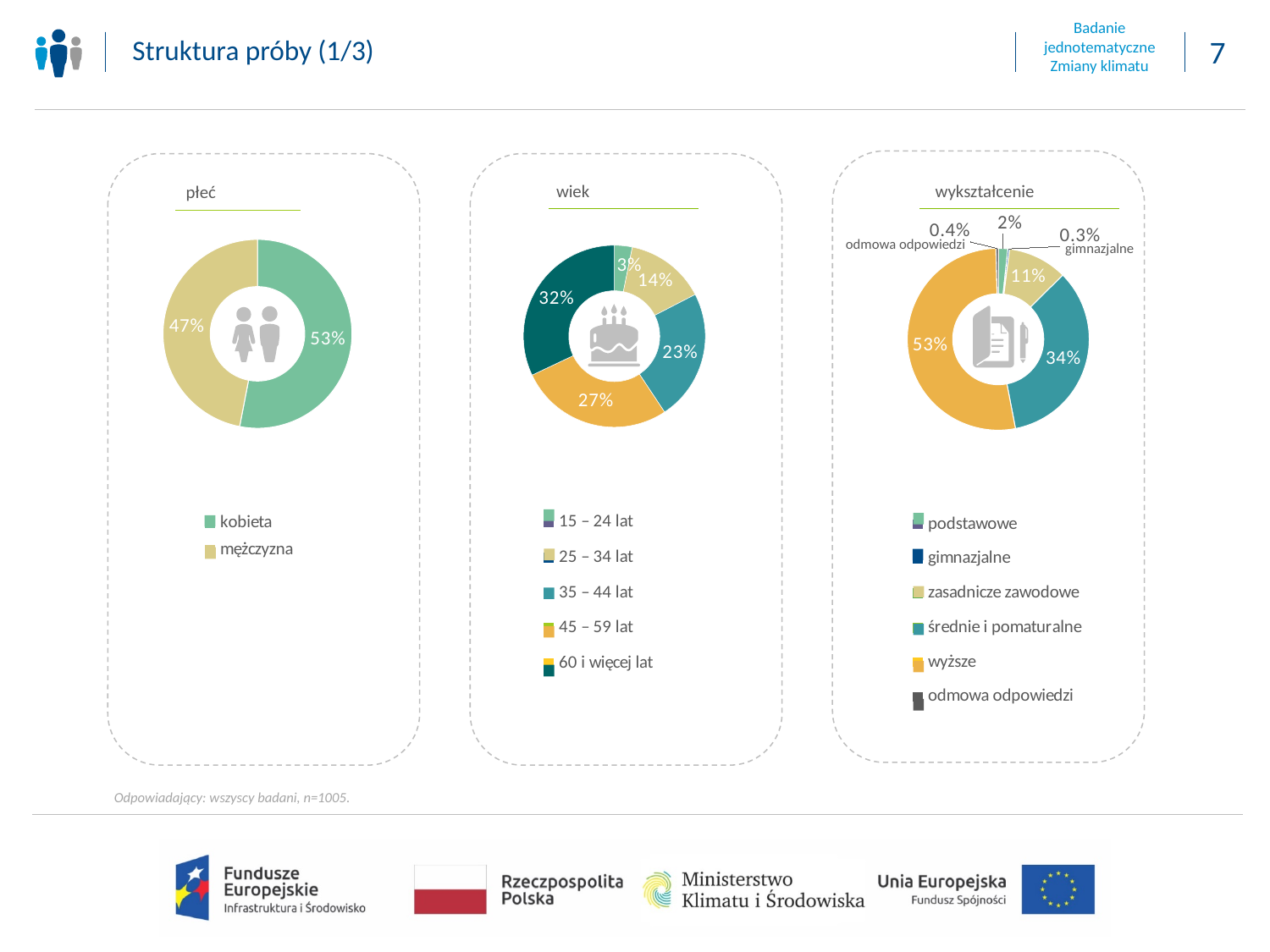
In the 'wykształcenie' chart, what percentage is shown for wyższe? 53% In the 'wykształcenie' chart, what percentage is shown for gimnazjalne? 0.3% In the 'wiek' chart, which age group has the smallest share? 15 – 24 lat In the 'płeć' chart, what percentage is shown for mężczyzna? 47% In the 'płeć' chart, what percentage is shown for kobieta? 53% In the 'wiek' chart, what percentage is shown for the 60 i więcej lat group? 32% What type of chart is used for the 'płeć' data? Donut (pie) chart In the 'wiek' chart, how many age groups does the legend list? 5 In the 'wykształcenie' chart, which is larger: średnie i pomaturalne or zasadnicze zawodowe? średnie i pomaturalne In the 'wykształcenie' chart, how many categories does the legend list? 6 In the 'wiek' chart, which age group has the largest share? 60 i więcej lat In the 'płeć' chart, what is the difference between the kobieta and mężczyzna shares? 6%